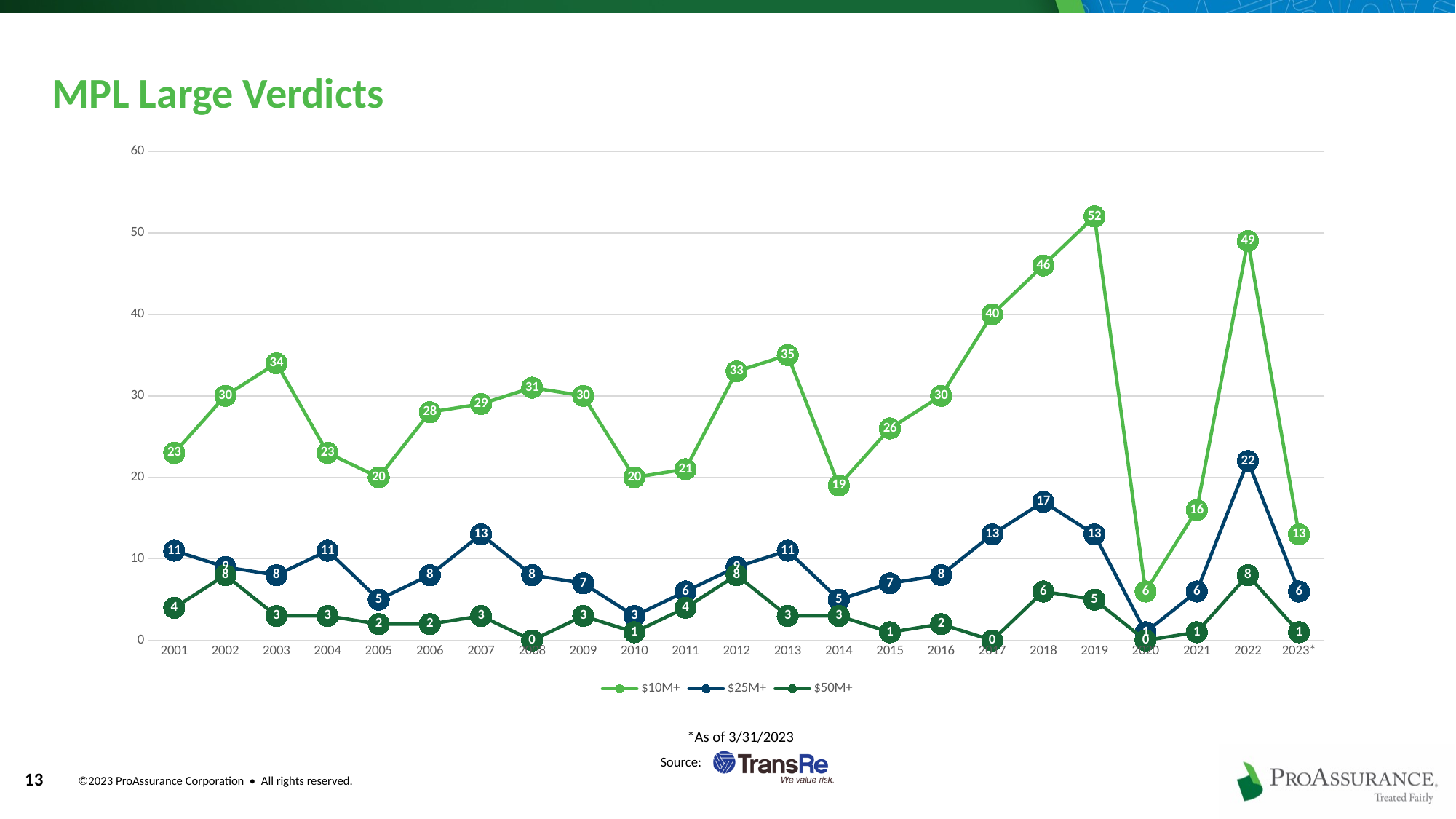
How many series does the legend list? 3 What is the title of the chart? MPL Large Verdicts What is the value of the $10M+ series in 2019? 52 What is the difference between the $10M+ value in 2019 and the $10M+ value in 2020? 46 How many years are plotted on the x axis? 23 What is the value of the $50M+ series in 2012? 8 Does the $10M+ series rise or fall from 2014 to 2019? rise What type of chart is shown on the slide? line chart Which is larger, the $25M+ value in 2018 or the $25M+ value in 2019? 2018 In which year does the $10M+ series reach its highest value? 2019 What is the value of the $25M+ series in 2022? 22 In which year does the $10M+ series have its lowest value? 2020